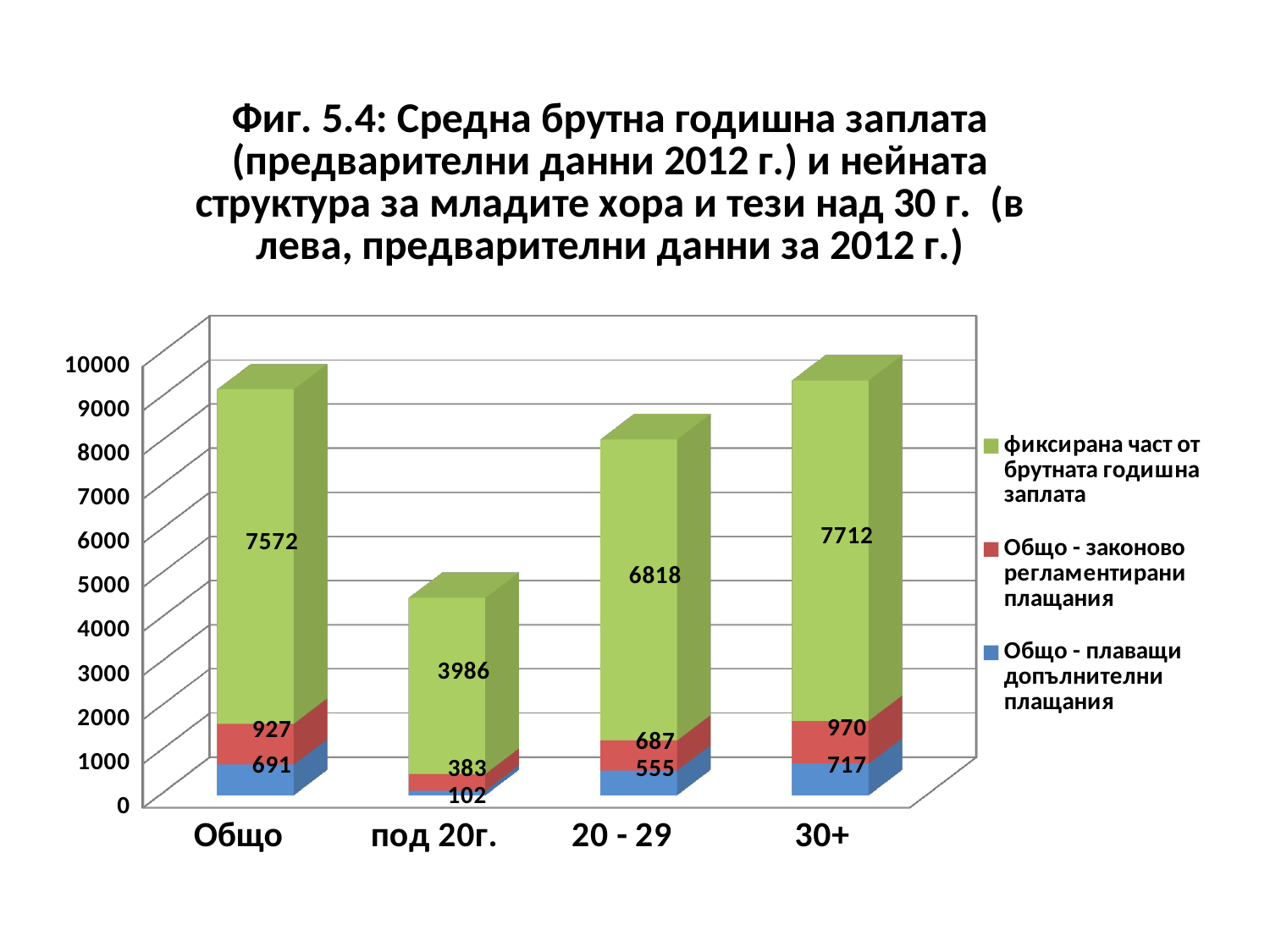
What is the total of the stacked bar for the 'под 20г.' category? 4471 What is the value of 'фиксирана част от брутната годишна заплата' for the '20 - 29' category? 6818 Which is larger: 'Общо - законово регламентирани плащания' for 'Общо' or for '20 - 29'? Общо What is the difference between the 'фиксирана част от брутната годишна заплата' values for '30+' and 'Общо'? 140 What type of chart is shown on the slide? bar chart Which colour represents 'Общо - плаващи допълнителни плащания' in the legend? blue How many categories are shown on the x axis? 4 Which category has the lowest value for 'Общо - плаващи допълнителни плащания'? под 20г. How many series does the legend list? 3 What is the value of 'Общо - законово регламентирани плащания' for the '30+' category? 970 What is the value of 'Общо - плаващи допълнителни плащания' for the 'под 20г.' category? 102 Which category has the highest value for 'фиксирана част от брутната годишна заплата'? 30+